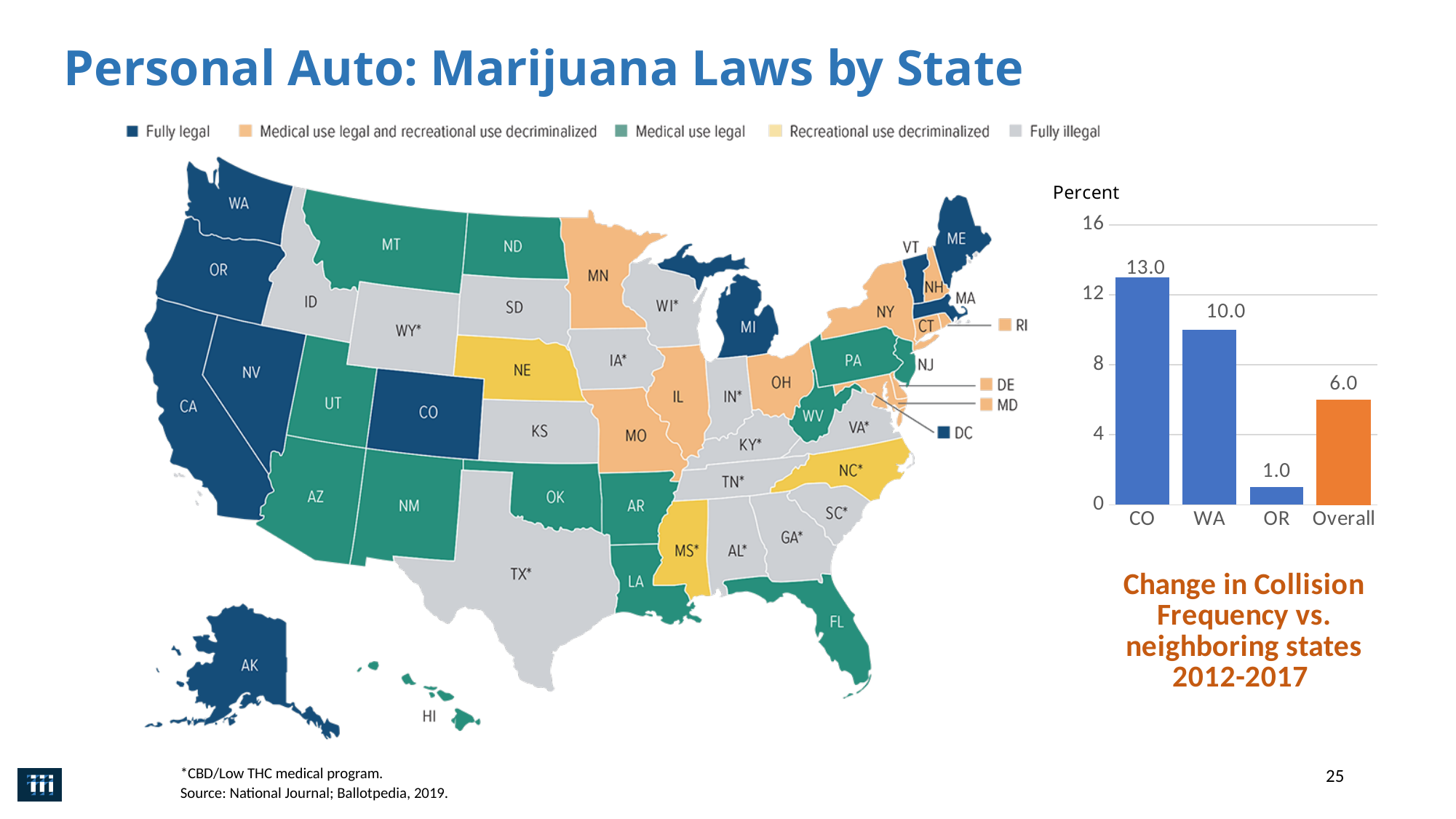
In the bar chart on the right, which is larger, the value for OR or the value for Overall? Overall In the bar chart on the right, what is the difference between the values for WA and Overall? 4.0 In the bar chart on the right, what is the value for OR? 1.0 In the bar chart on the right, what is the value for CO? 13.0 How many bars are shown in the bar chart on the right? 4 What kind of chart is shown on the right side of the slide? Bar chart In the bar chart on the right, which category has the highest value? CO In the bar chart on the right, is the value for CO greater or less than 12? greater In the bar chart on the right, what is the value for Overall? 6.0 In the bar chart on the right, what is the difference between the values for CO and WA? 3.0 In the bar chart on the right, what is the value for WA? 10.0 In the bar chart on the right, which category has the lowest value? OR